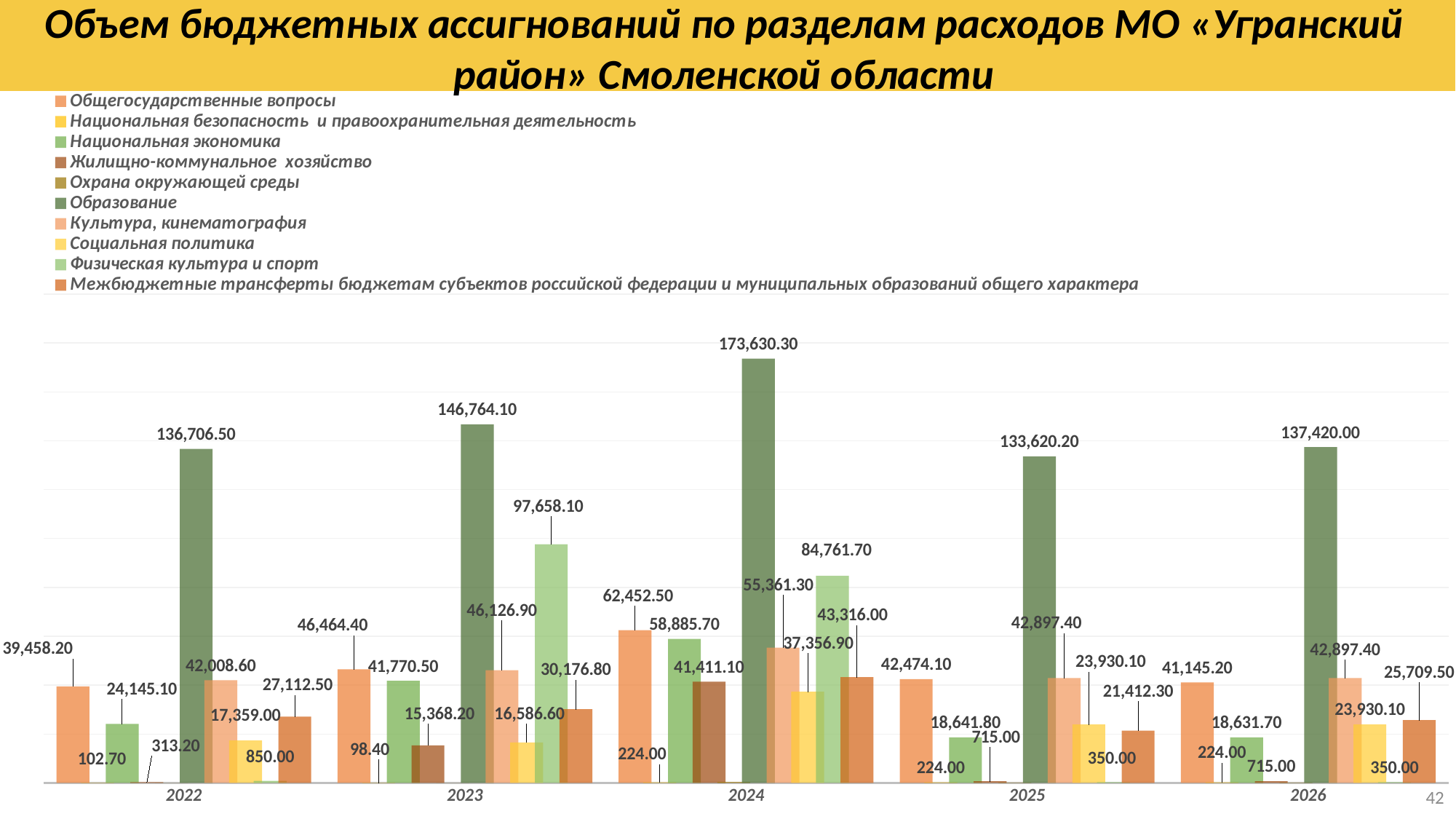
What type of chart is shown on the slide? bar chart How many series does the legend list? 10 Does the value for Образование rise or fall from 2022 to 2024? rise Which is larger in 2024: Общегосударственные вопросы or Национальная экономика? Общегосударственные вопросы What is the difference between the Образование values for 2024 and 2023? 26,866.20 How many years are shown along the x axis? 5 What is the value for Общегосударственные вопросы in 2022? 39,458.20 What is the value for Межбюджетные трансферты бюджетам субъектов российской федерации и муниципальных образований общего характера in 2026? 25,709.50 In which year is the value for Образование highest? 2024 What is the value for Физическая культура и спорт in 2023? 97,658.10 What is the value for Образование in 2024? 173,630.30 In which year is the value for Образование lowest? 2025